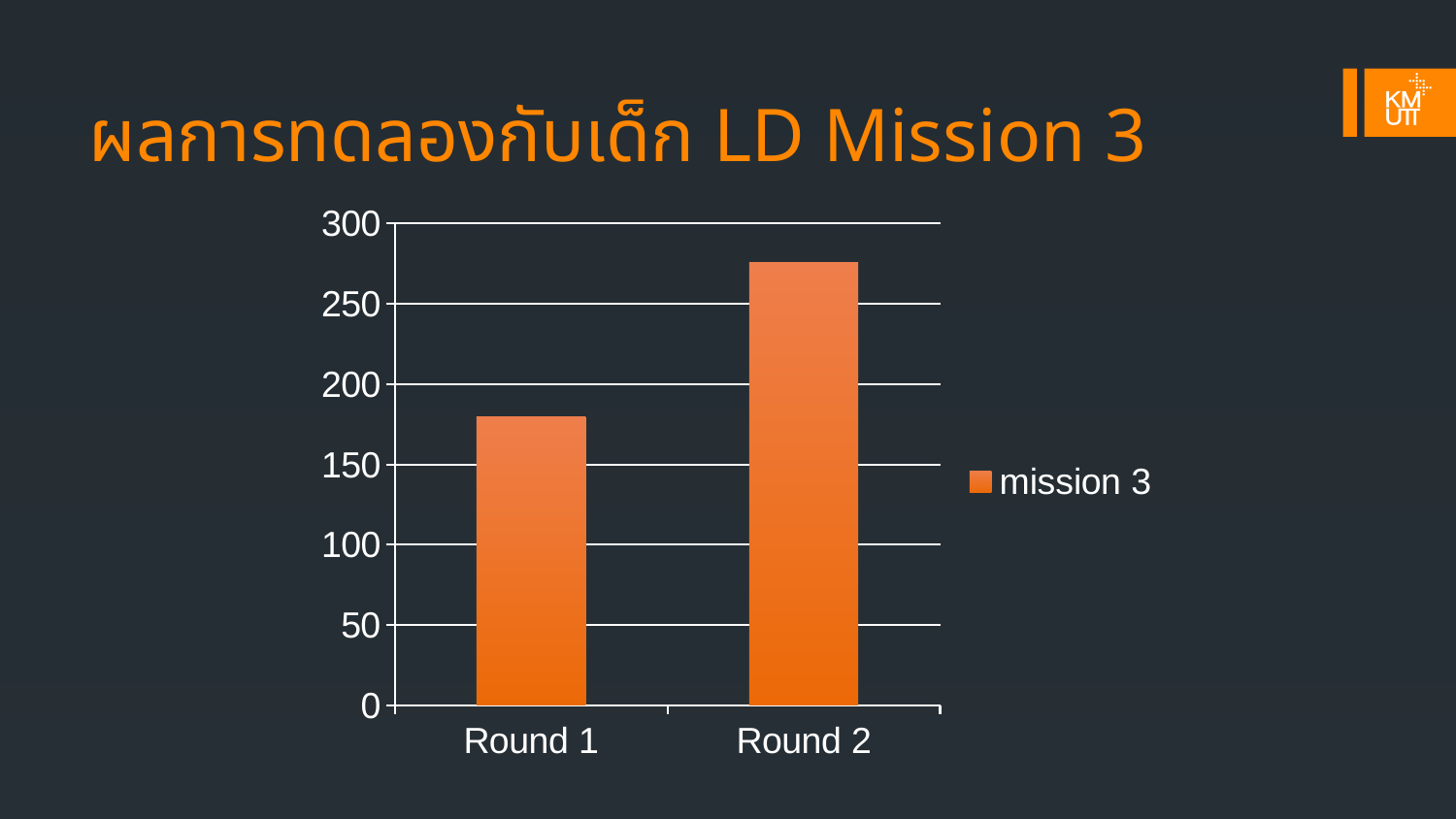
How many series does the legend list? 1 Do the values rise or fall from Round 1 to Round 2? rise Is the value for Round 2 greater or less than 250? greater How many categories are shown on the x axis? 2 What is the name of the series in the legend? mission 3 Is the value for Round 1 greater or less than 150? greater Is the value for Round 1 greater or less than 200? less Which round has the lowest value? Round 1 What kind of chart is shown on the slide? bar chart Which is larger, the value for Round 1 or Round 2? Round 2 Which round has the highest value? Round 2